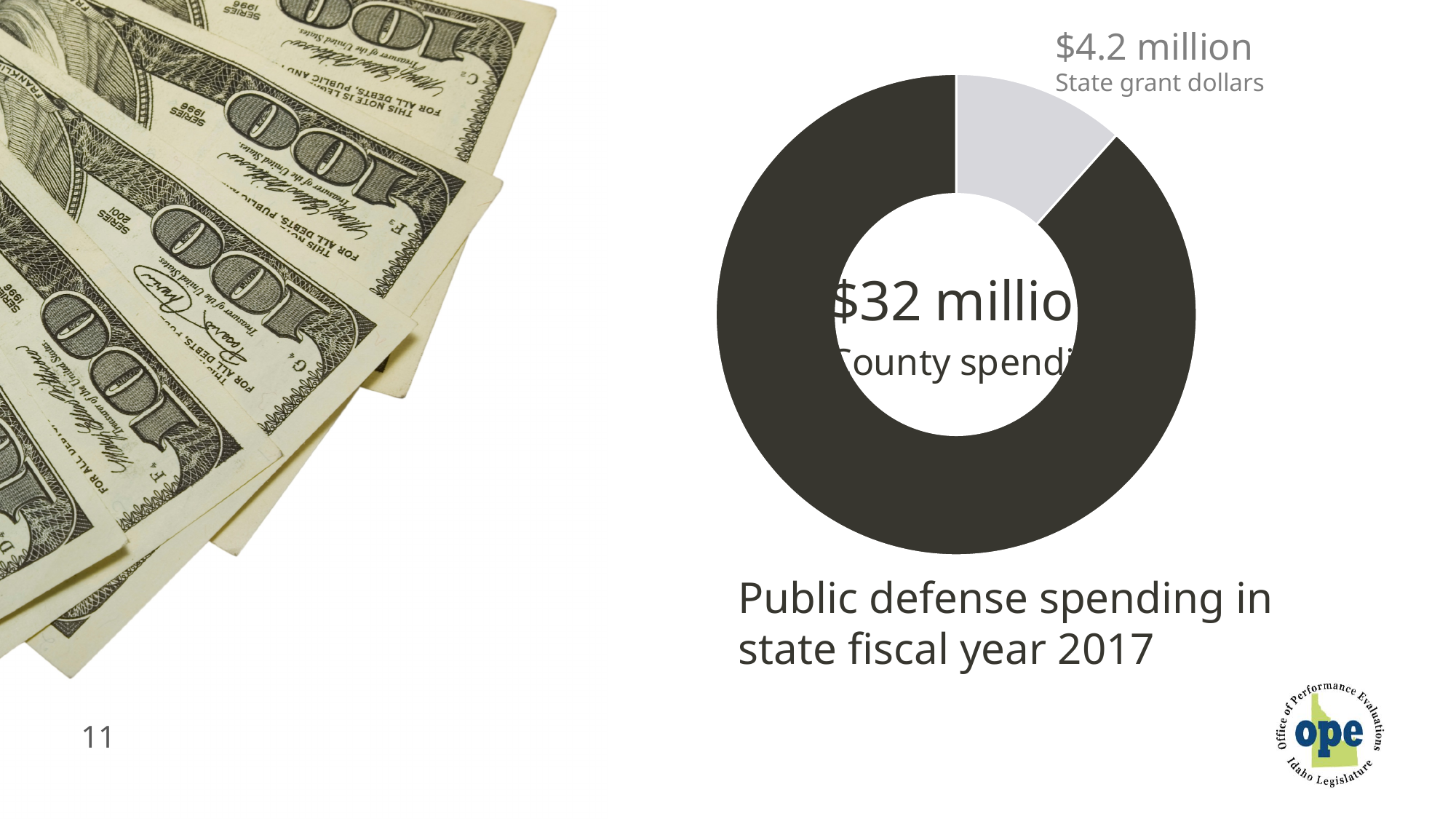
What is the value of the State grant dollars segment in the donut chart? $4.2 million What is the value of the County spending segment in the donut chart? $32 million Which segment of the donut chart is the smallest? State grant dollars What is the total of the two segments shown in the donut chart? $36.2 million Which is larger, County spending or State grant dollars? County spending What type of chart is shown on the slide? Donut chart How many segments does the donut chart have? 2 Which segment of the donut chart is the largest? County spending What is the title of the chart? Public defense spending in state fiscal year 2017 What is the difference between County spending and State grant dollars? $27.8 million Which segment is shown in light gray? State grant dollars